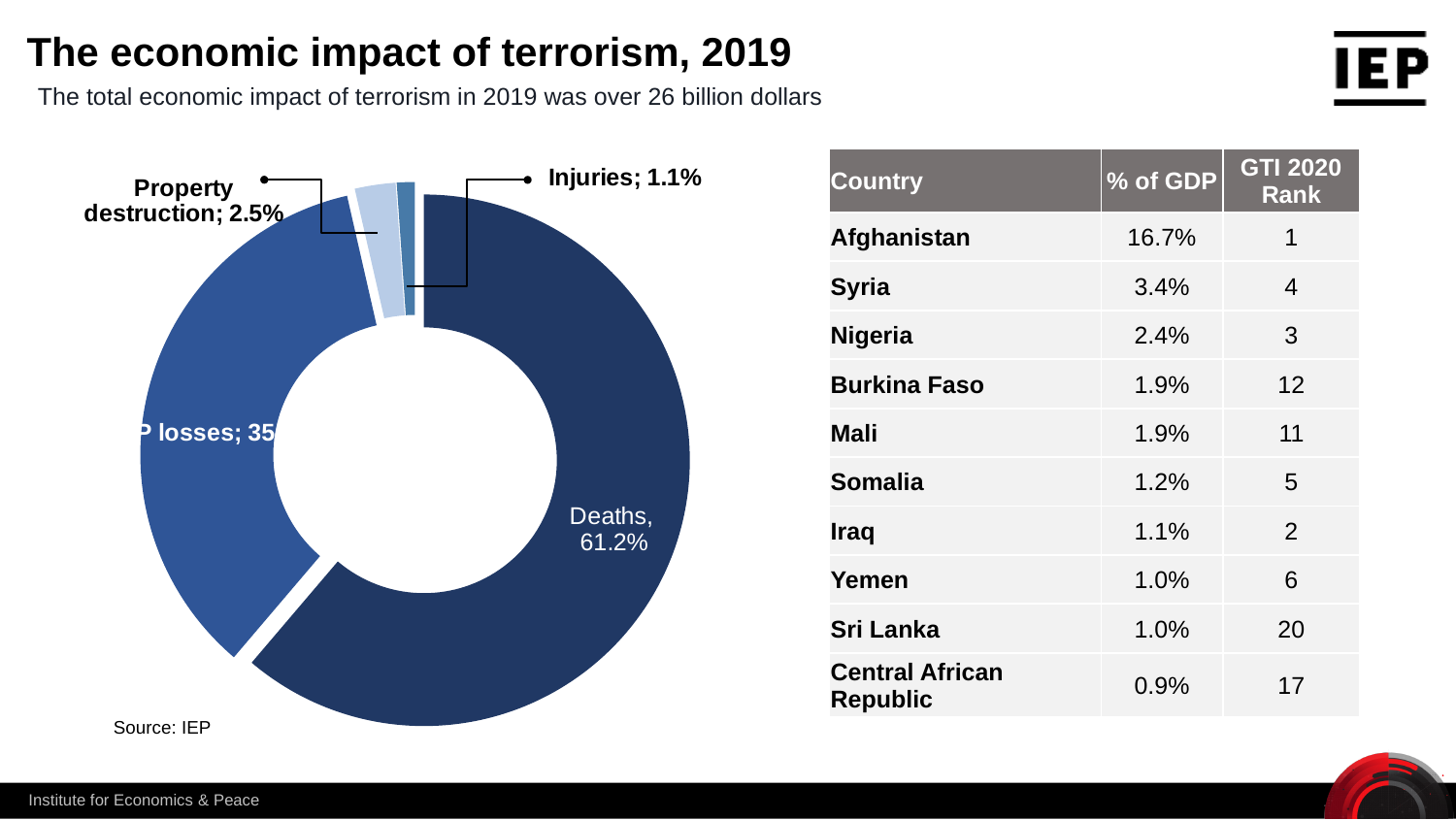
What is the difference in percentage points between the Property destruction share and the Injuries share? 1.4 percentage points What share of the economic impact of terrorism is attributed to Injuries? 1.1% What source is cited below the donut chart? IEP What kind of chart is shown on the slide? Donut (pie) chart What share of the economic impact of terrorism is attributed to Property destruction? 2.5% What is the difference in percentage points between the Deaths share and the Property destruction share? 58.7 percentage points How many slices does the donut chart have? 4 What share of the economic impact of terrorism is attributed to Deaths? 61.2% Which is larger in the donut chart, the share for Property destruction or the share for Injuries? Property destruction Which is larger in the donut chart, the share for Deaths or the share for GDP losses? Deaths Which category accounts for the smallest share of the donut chart? Injuries Which category accounts for the largest share of the donut chart? Deaths